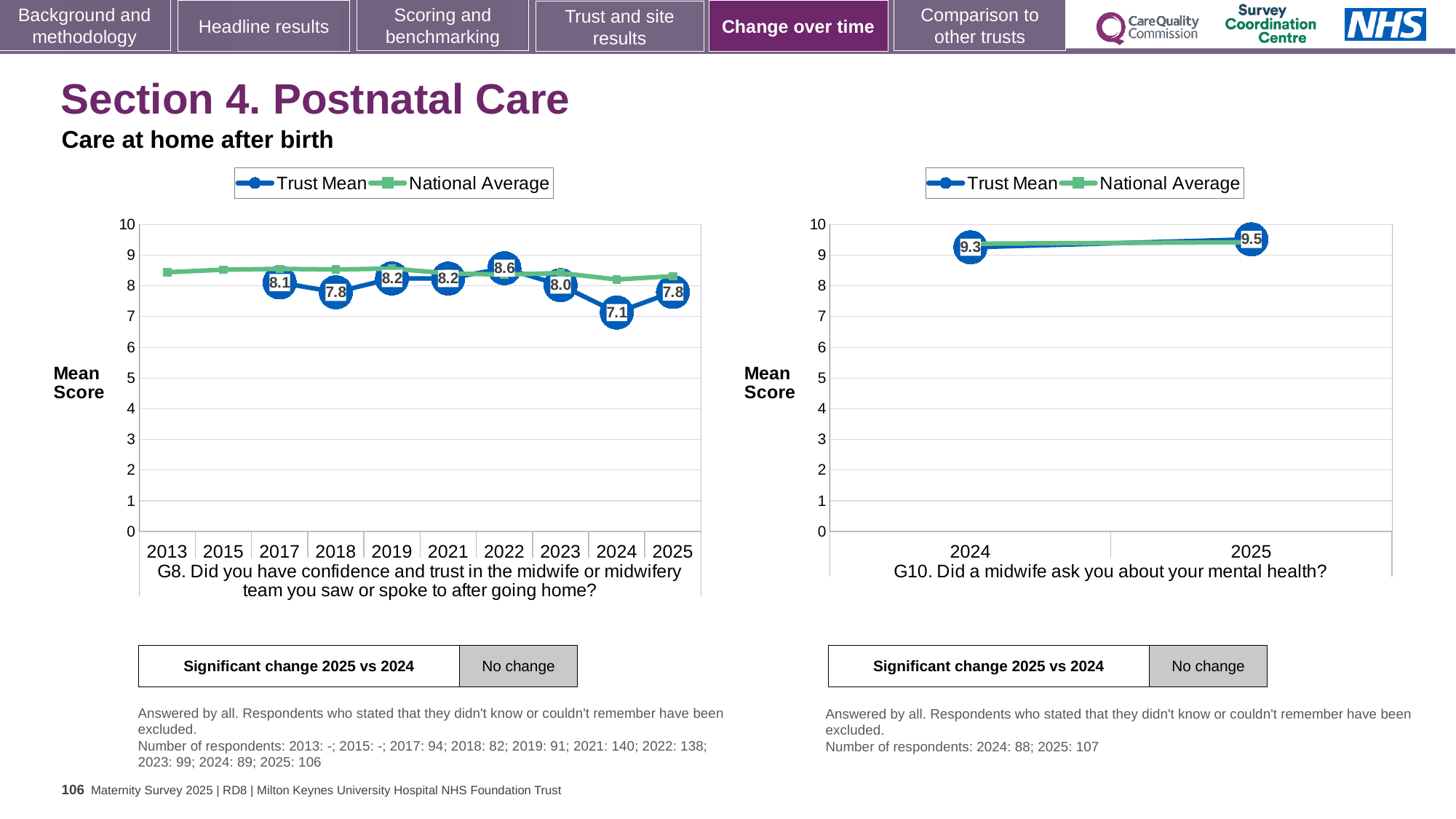
In the G8 chart on the left, which year has the highest Trust Mean? 2022 In the G8 chart on the left, which year has the lowest Trust Mean? 2024 How many years are shown on the x axis of the G8 chart on the left? 10 In the G8 chart on the left, is the Trust Mean higher in 2018 or in 2019? 2019 In the G8 chart on the left, is the National Average for 2013 greater or less than 8? greater In the G8 chart on the left, what is the difference between the Trust Mean in 2025 and in 2024? 0.7 What type of chart is the G10 chart on the right? line chart In the G8 chart on the left, what is the Trust Mean for 2022? 8.6 In the G8 chart on the left, what is the Trust Mean for 2024? 7.1 In the G10 chart on the right, what is the Trust Mean for 2025? 9.5 In the G10 chart on the right, did the Trust Mean rise or fall from 2024 to 2025? rise How many series does the legend of the G10 chart on the right list? 2